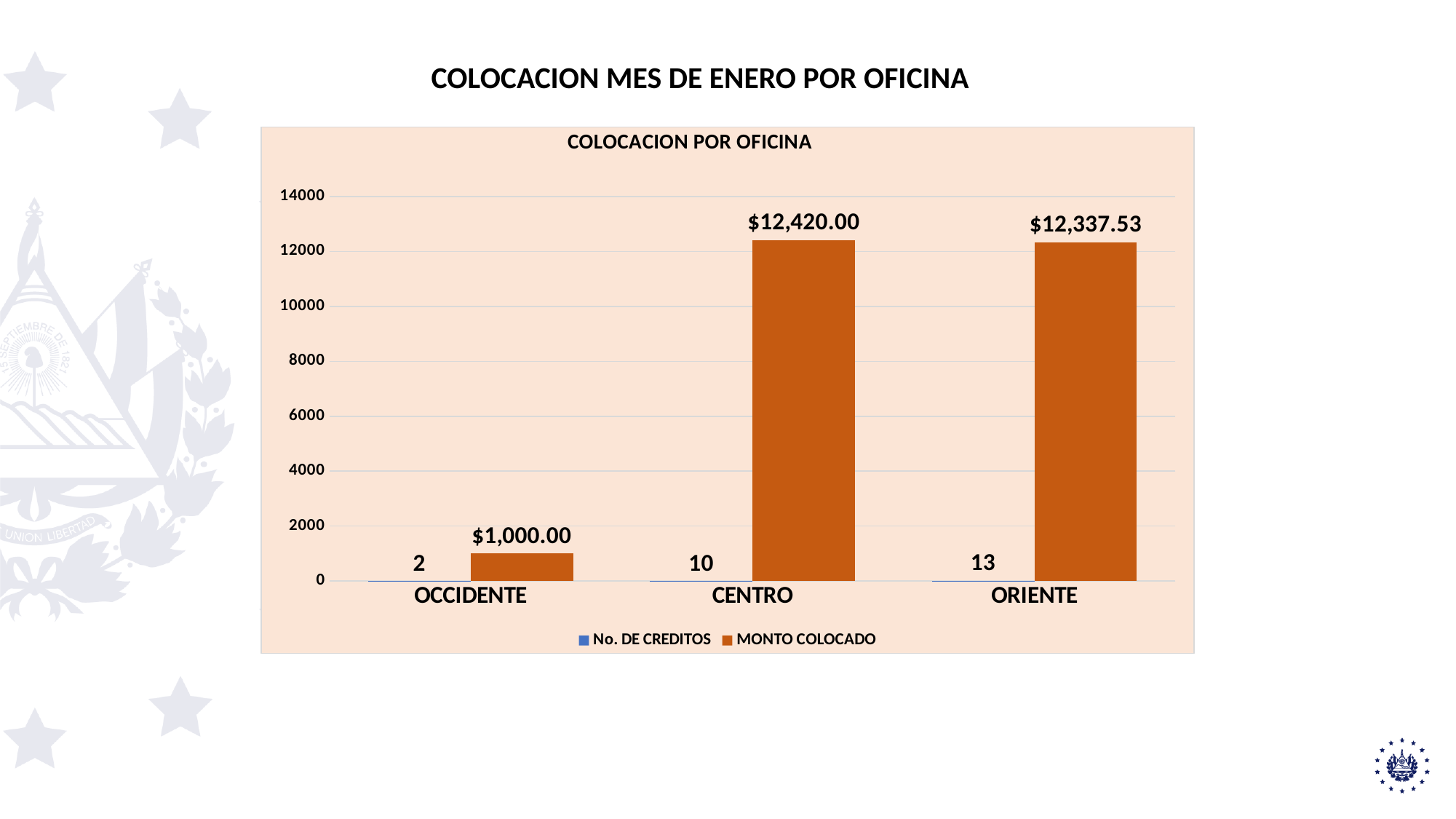
How many series does the legend list? 2 What is the difference in MONTO COLOCADO between CENTRO and ORIENTE? $82.47 What is the No. DE CREDITOS value for ORIENTE? 13 What kind of chart is shown on the slide? Bar chart How many offices are shown on the x axis? 3 What is the MONTO COLOCADO value for OCCIDENTE? $1,000.00 What is the difference in No. DE CREDITOS between ORIENTE and OCCIDENTE? 11 Which office has the lowest No. DE CREDITOS? OCCIDENTE Which has a larger MONTO COLOCADO, OCCIDENTE or ORIENTE? ORIENTE What is the No. DE CREDITOS value for CENTRO? 10 Which office has the highest MONTO COLOCADO? CENTRO What is the MONTO COLOCADO value for CENTRO? $12,420.00